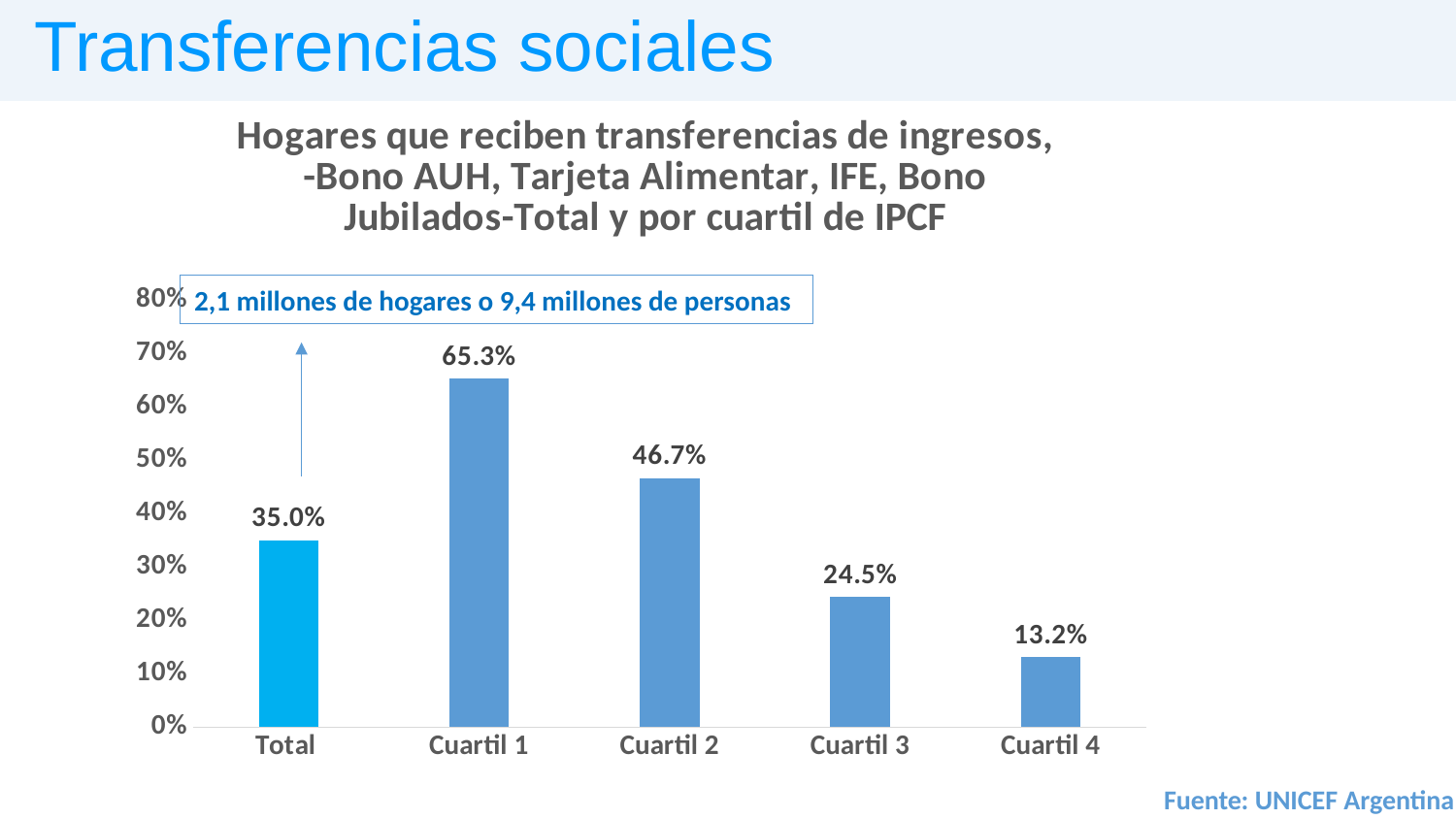
What is the value for Cuartil 4? 13.2% What is the value for Cuartil 1? 65.3% Do the values rise or fall from Cuartil 1 to Cuartil 4? fall Which is larger, the value for Cuartil 2 or the value for Total? Cuartil 2 Which category has the lowest value? Cuartil 4 Is the value for Cuartil 3 greater or less than 30%? less How many categories are shown on the x axis? 5 Which category has the highest value? Cuartil 1 What kind of chart is shown on the slide? bar chart What is the difference between the values for Cuartil 1 and Cuartil 2? 18.6% What is the value for Total? 35.0% What is the difference between the values for Cuartil 3 and Cuartil 4? 11.3%